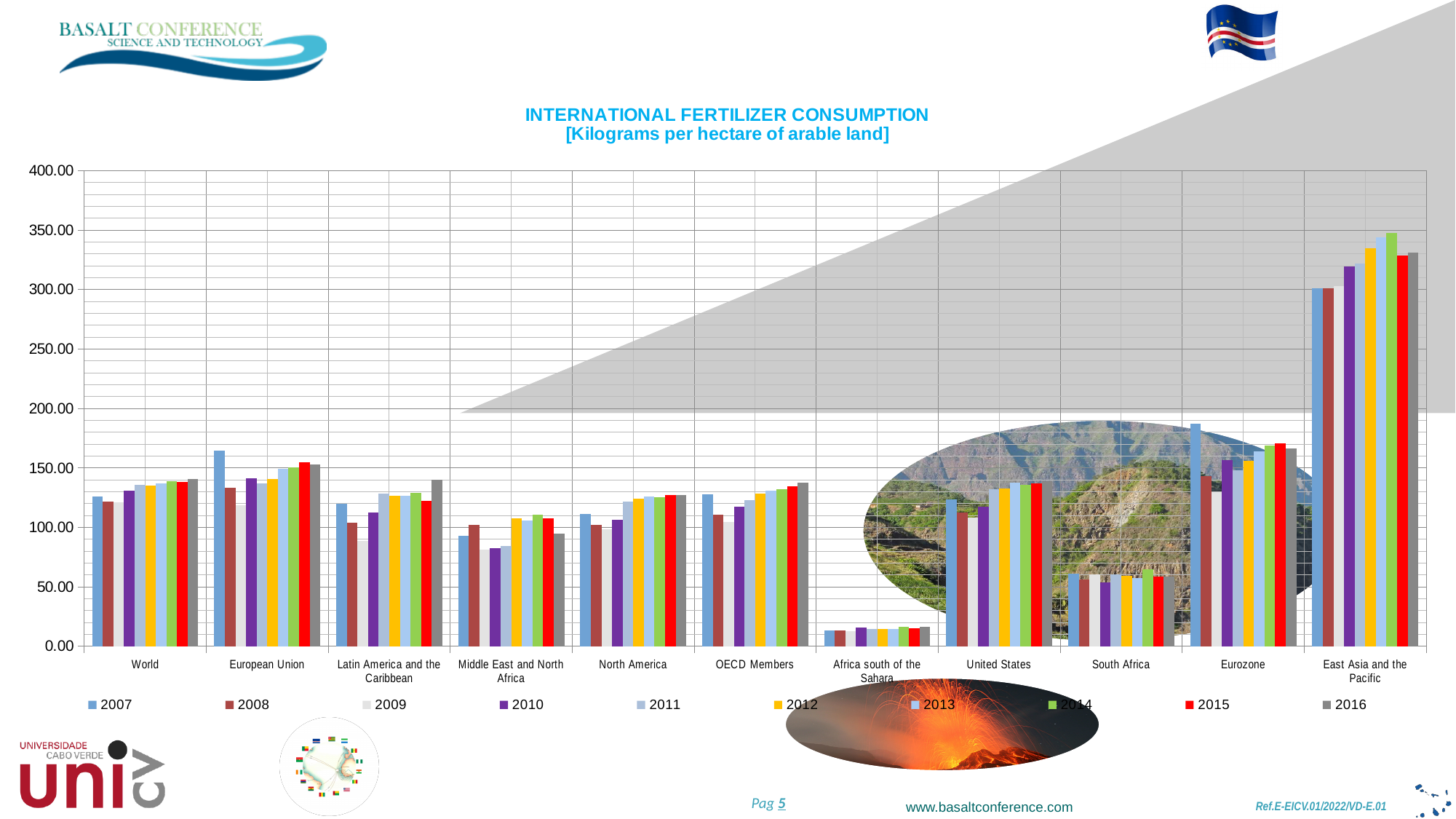
Which is larger in 2007: the value for Eurozone or the value for United States? Eurozone Is the value for European Union in 2007 greater or less than 150.00? greater What kind of chart is shown on the slide? bar chart Is the value for East Asia and the Pacific in 2014 greater or less than 300.00? greater Which category has the lowest fertilizer consumption values? Africa south of the Sahara Is the value for South Africa in 2008 greater or less than 100.00? less What is the title of the chart? INTERNATIONAL FERTILIZER CONSUMPTION [Kilograms per hectare of arable land] How many series does the legend list? 10 Do the values for East Asia and the Pacific rise or fall from 2007 to 2013? rise How many categories (regions/countries) are shown on the x axis? 11 Which category has the highest fertilizer consumption values? East Asia and the Pacific